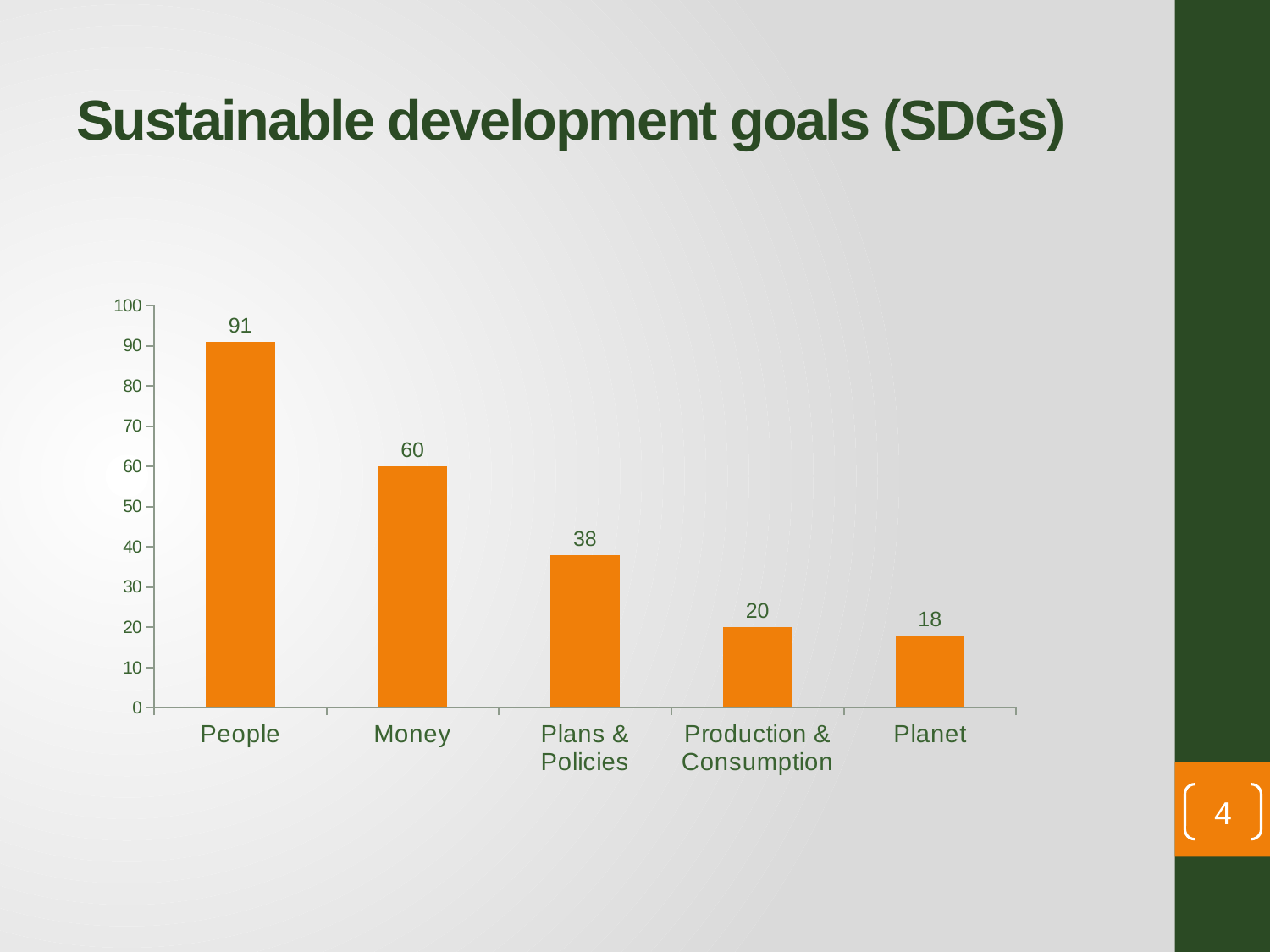
What kind of chart is shown on the slide? Bar chart Which category has the lowest value? Planet Which category has the highest value? People What is the value for Planet? 18 What is the difference between the values for People and Money? 31 What is the value for Money? 60 What is the value for People? 91 Which is larger, the value for Money or the value for Plans & Policies? Money Do the values rise or fall from left to right along the x axis? Fall How many categories are shown on the x axis? 5 What is the value for Plans & Policies? 38 What is the value for Production & Consumption? 20